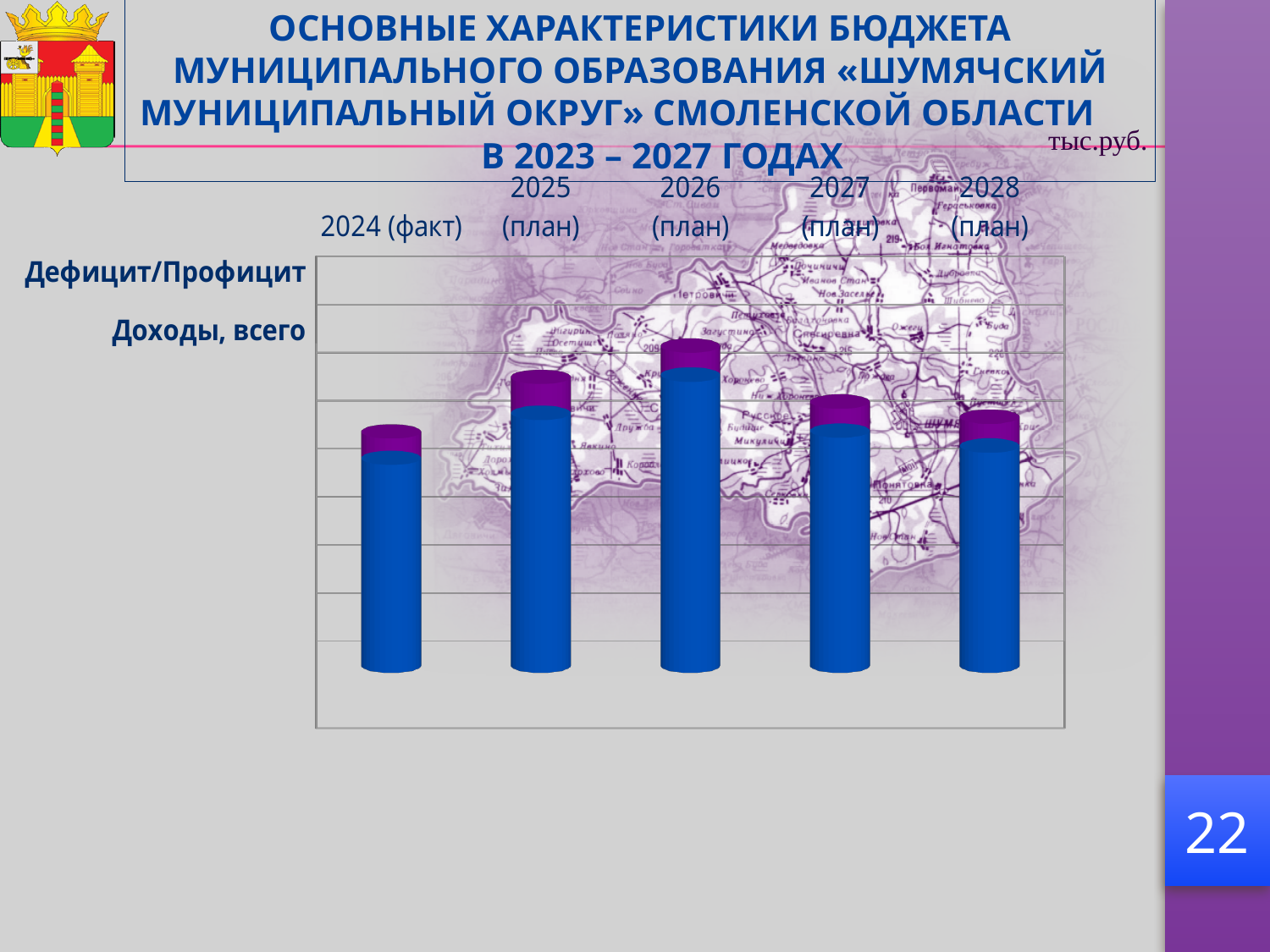
Do the bars rise or fall from 2024 (факт) to 2026 (план)? rise Which year has the shortest bar on the chart? 2024 (факт) Which bar is taller, 2025 (план) or 2027 (план)? 2025 (план) What kind of chart is shown on the slide? bar chart Which bar is taller, 2024 (факт) or 2028 (план)? 2028 (план) Which year has the tallest bar on the chart? 2026 (план) How many year categories are plotted on the chart? 5 What unit of measurement is indicated for the chart? тыс.руб. Do the bars rise or fall from 2026 (план) to 2028 (план)? fall